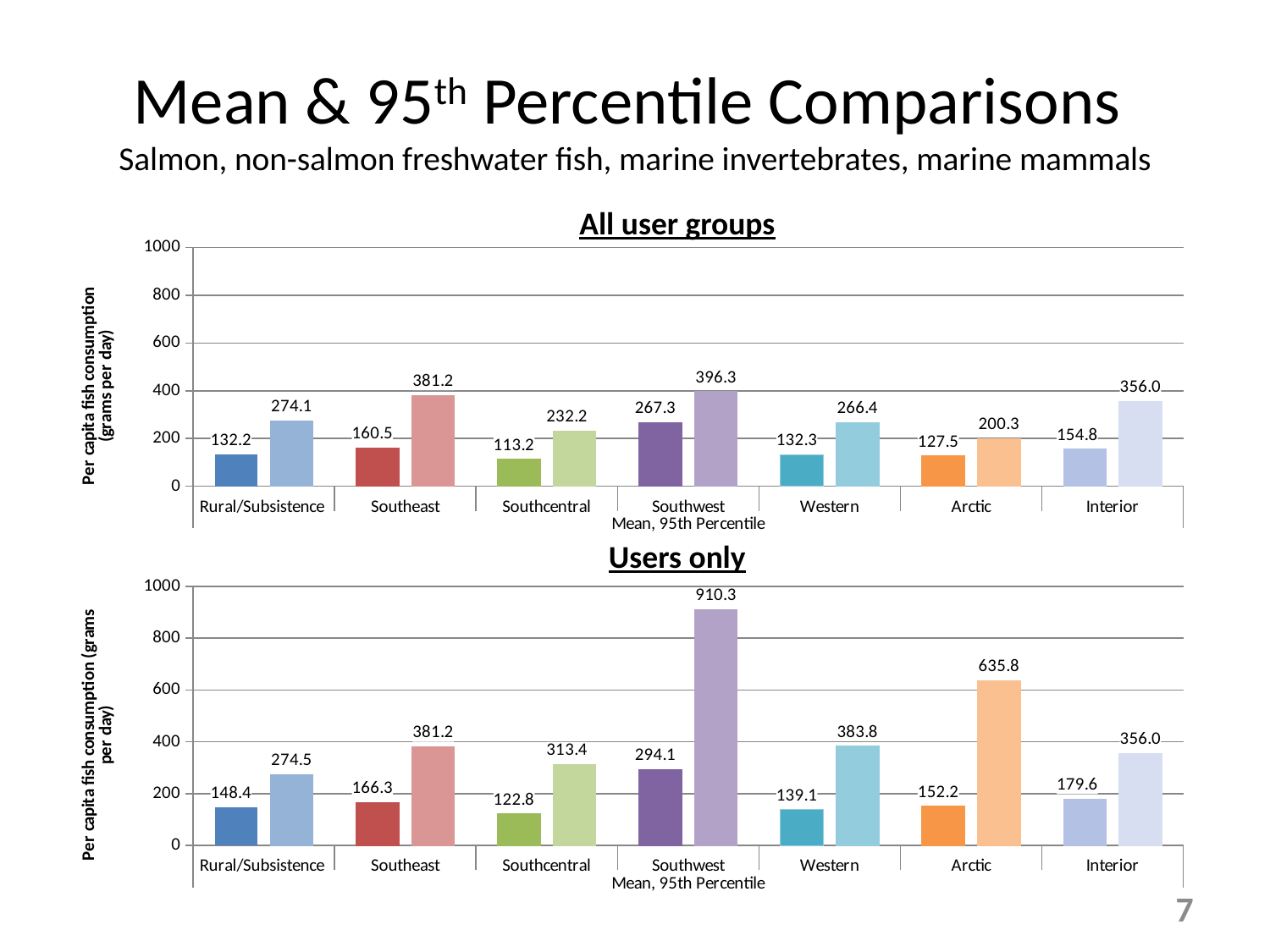
In the 'All user groups' chart, what is the mean per capita fish consumption for Southeast? 160.5 What type of chart is the 'All user groups' chart? bar chart In the 'All user groups' chart, what is the 95th percentile value for Southwest? 396.3 In the 'Users only' chart, what is the difference between the 95th percentile and mean values for Southwest? 616.2 In the 'Users only' chart, which region has the highest 95th percentile value? Southwest In the 'Users only' chart, what is the mean value for Interior? 179.6 How many regions are shown on the x axis of the 'Users only' chart? 7 What is the y-axis label of the 'All user groups' chart? Per capita fish consumption (grams per day) In the 'Users only' chart, is the 95th percentile value for Southwest greater or less than 800? greater In the 'All user groups' chart, which is larger: the 95th percentile for Southeast or the 95th percentile for Interior? Southeast In the 'All user groups' chart, which region has the lowest mean value? Southcentral In the 'Users only' chart, what is the 95th percentile value for Arctic? 635.8